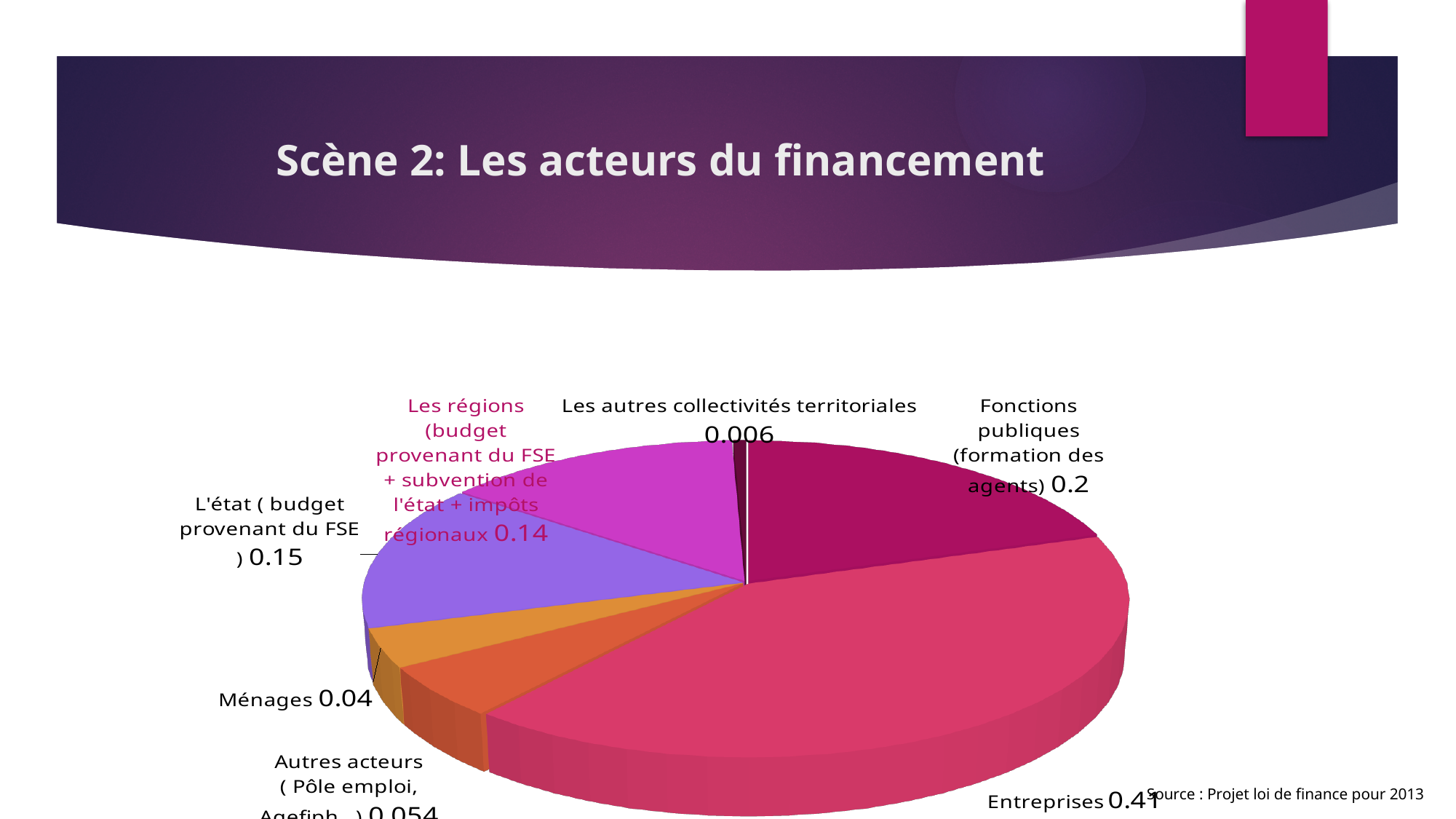
Which category has the smallest slice of the pie? Les autres collectivités territoriales Which category has the largest slice of the pie? Entreprises What is the source cited below the chart? Projet loi de finance pour 2013 What is the value for Ménages? 0.04 What is the value for Fonctions publiques (formation des agents)? 0.2 What is the value for Entreprises? 0.41 How many categories are shown in the pie chart? 7 What is the difference between the values for Entreprises and Fonctions publiques (formation des agents)? 0.21 What kind of chart is shown on the slide? pie chart What is the value for Les autres collectivités territoriales? 0.006 What is the value for L'état (budget provenant du FSE)? 0.15 Which is larger, the value for L'état (budget provenant du FSE) or the value for Les régions? L'état (budget provenant du FSE)